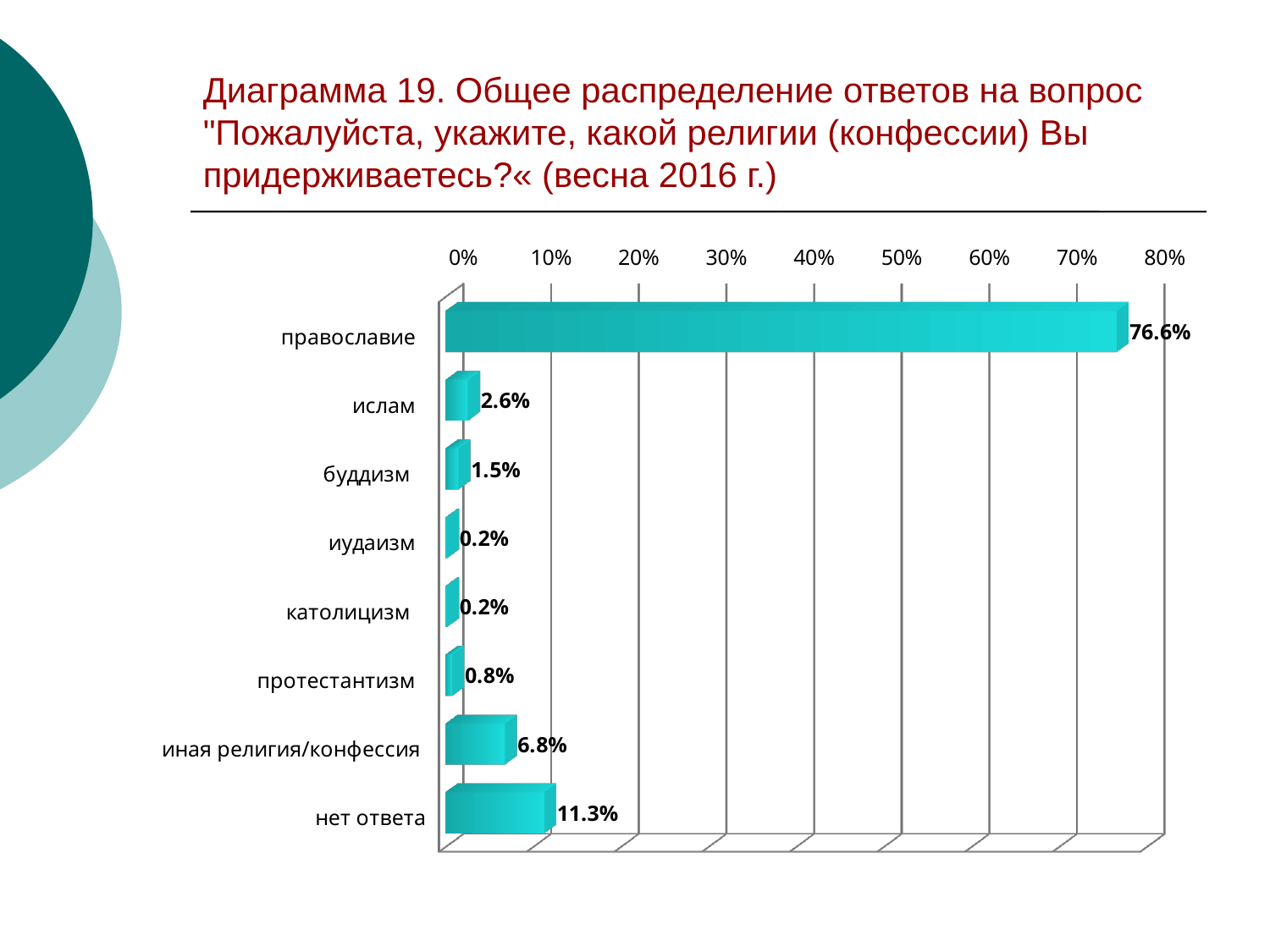
Which two categories share the lowest value of 0.2%? иудаизм and католицизм What is the difference between the values for ислам and буддизм? 1.1% What is the value for нет ответа? 11.3% What kind of chart is shown on the slide? bar chart What is the value for ислам? 2.6% How many categories are shown in the chart? 8 What is the value for православие? 76.6% What is the value for иная религия/конфессия? 6.8% Which is larger, the value for иная религия/конфессия or the value for ислам? иная религия/конфессия What is the difference between the values for православие and нет ответа? 65.3% Is the value for православие greater or less than 70%? greater Which category has the highest value? православие